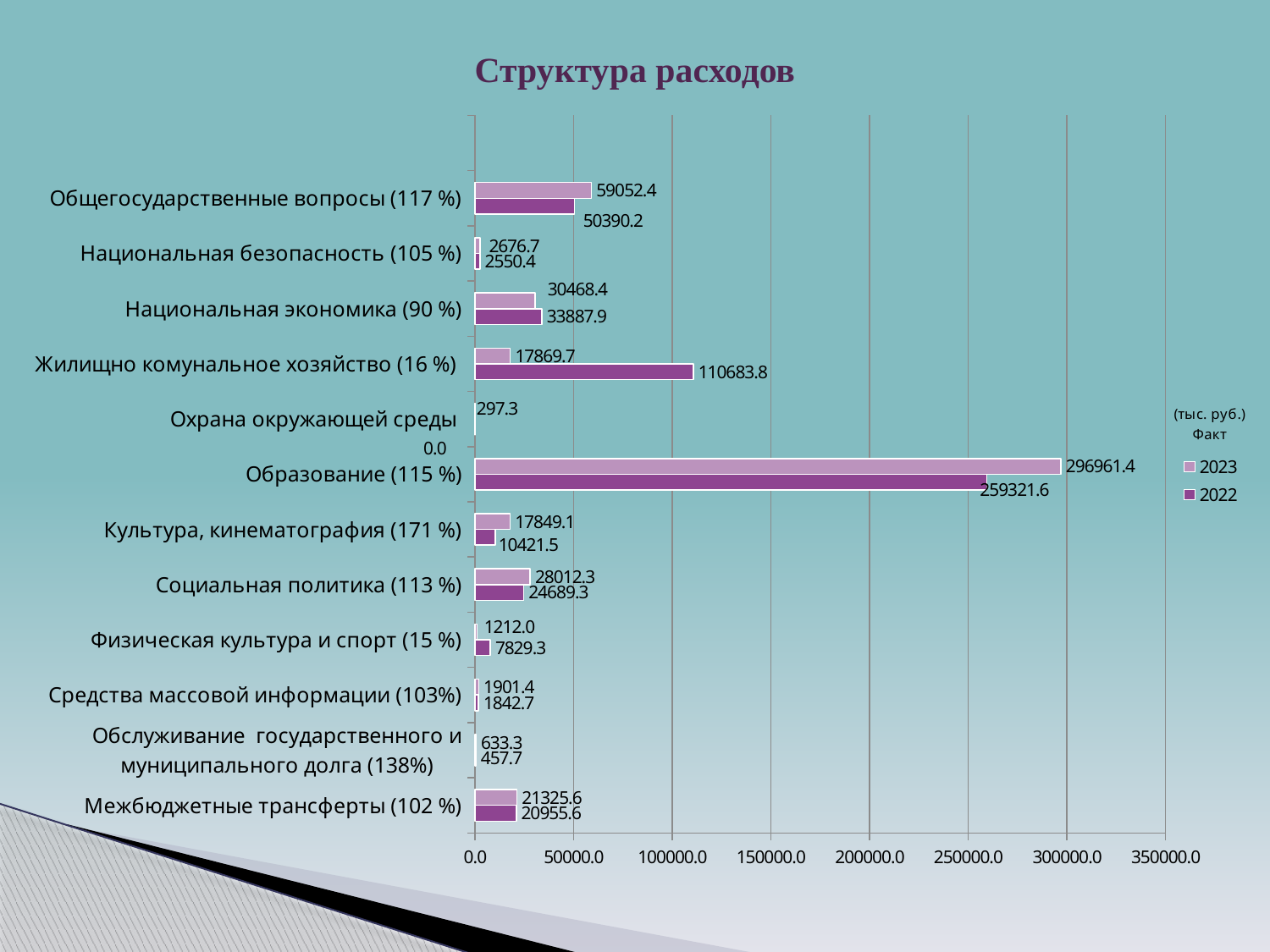
What is the title of the chart? Структура расходов Is the 2022 value for Образование (115 %) greater or less than 250000.0? greater Which category has the lowest 2022 value? Охрана окружающей среды What is the 2022 value for Жилищно коммунальное хозяйство (16 %)? 110683.8 What is the difference between the 2023 and 2022 values for Общегосударственные вопросы (117 %)? 8662.2 What type of chart is shown on the slide? bar chart How many categories are shown on the chart? 12 How many series does the legend list? 2 Which category has the highest 2023 value? Образование (115 %) What is the 2022 value for Охрана окружающей среды? 0.0 What is the 2023 value for Образование (115 %)? 296961.4 Which is larger for Физическая культура и спорт (15 %): the 2023 value or the 2022 value? 2022